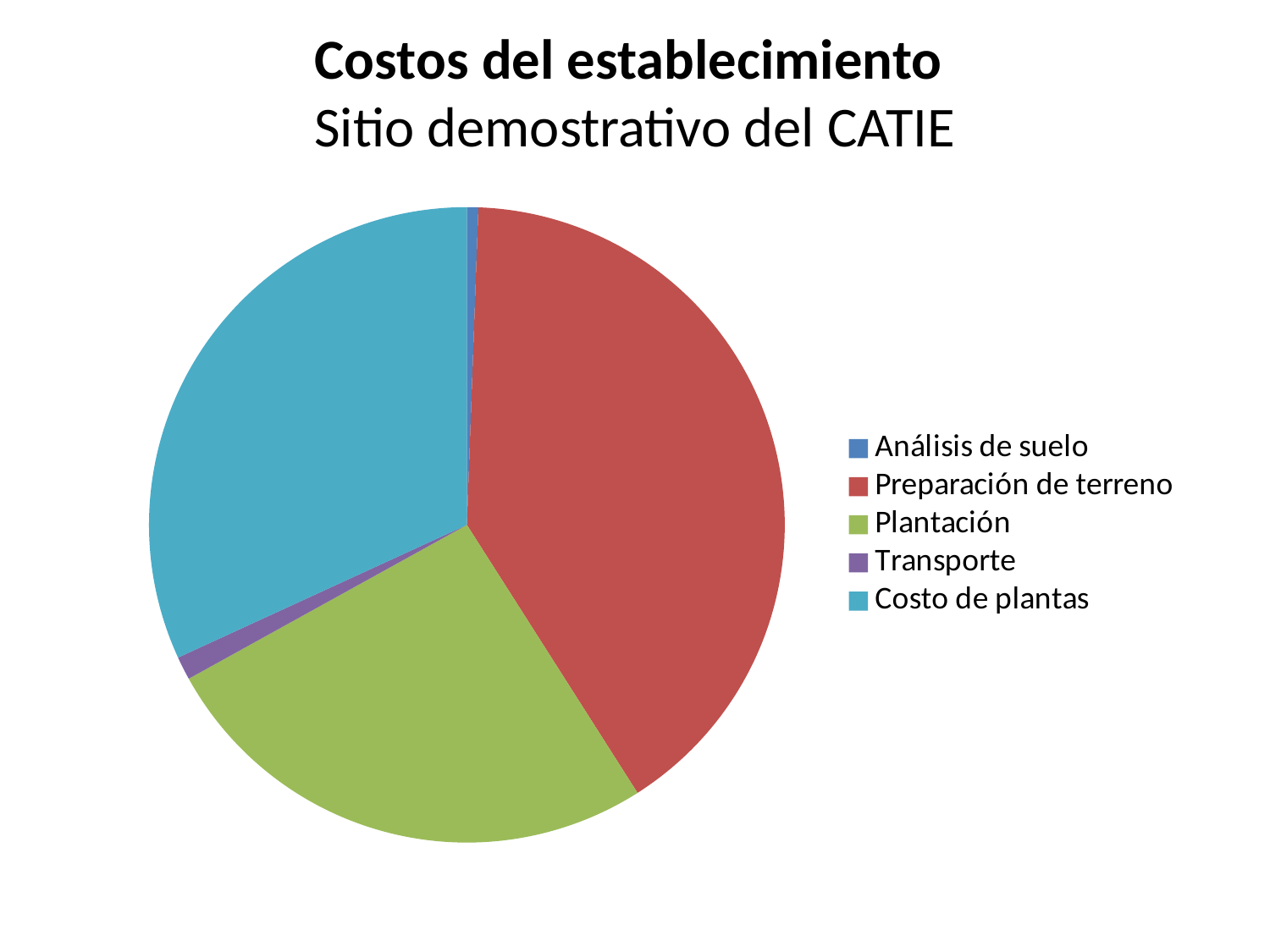
Which category has the smallest slice of the pie? Análisis de suelo What kind of chart is shown on the slide? Pie chart Which category has the largest slice of the pie? Preparación de terreno How many slices does the pie chart have? 5 What colour is the slice for Plantación? Green Which is larger, the slice for Preparación de terreno or the slice for Plantación? Preparación de terreno Which is larger, the slice for Costo de plantas or the slice for Plantación? Costo de plantas What is the title of the chart? Costos del establecimiento Sitio demostrativo del CATIE How many entries does the legend list? 5 Which is larger, the slice for Transporte or the slice for Análisis de suelo? Transporte